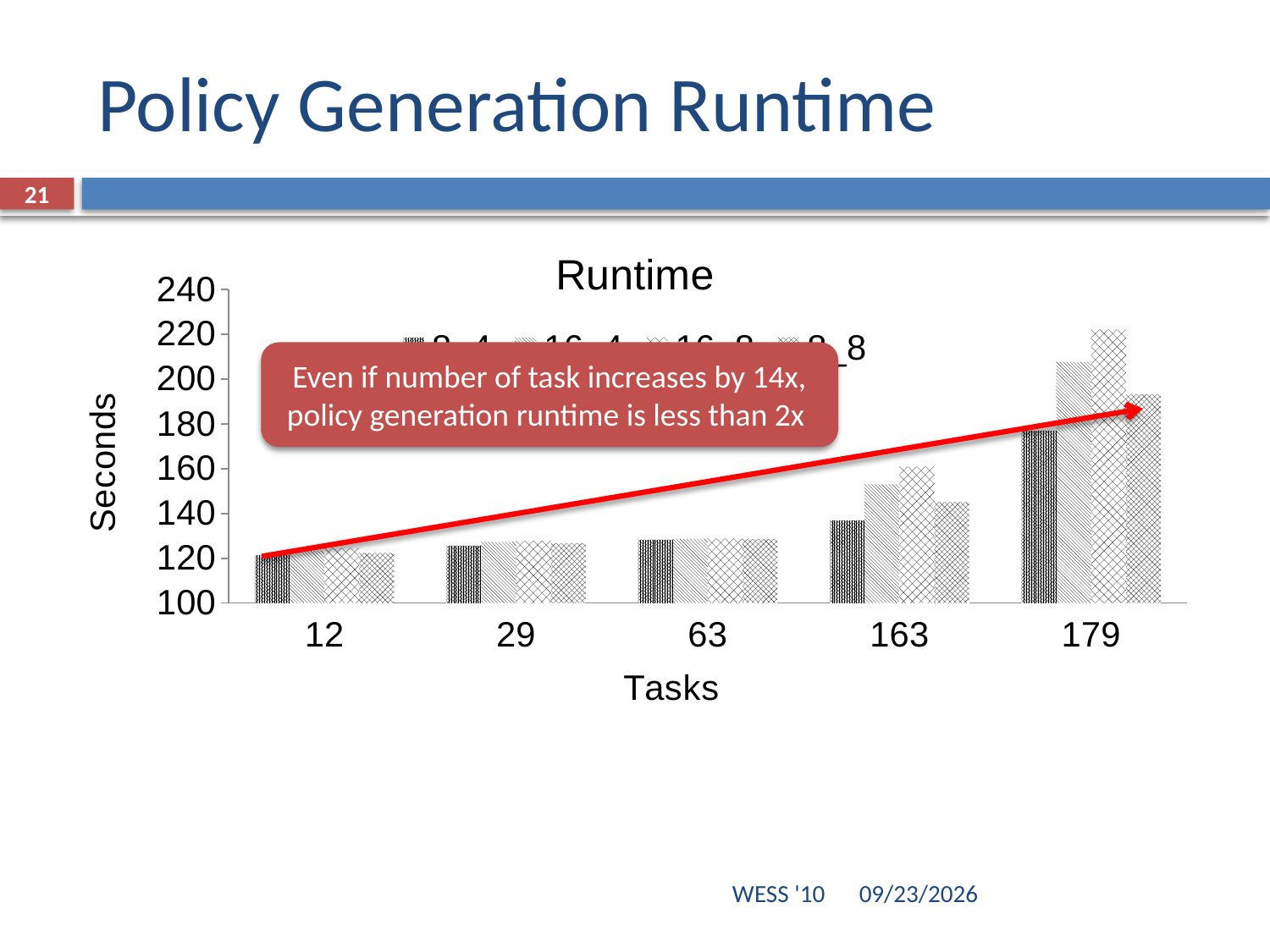
Which has taller bars in the chart, 163 tasks or 179 tasks? 179 Do the runtime values generally rise or fall as the number of tasks increases along the x axis? rise Are the bars for 12 tasks greater or less than 140? less What is the title of the chart? Runtime Are the bars for 63 tasks greater or less than 160? less What kind of chart is shown on the slide? bar chart How many bars are plotted for each task category in the chart? 4 How many task categories are shown on the x axis of the chart? 5 Which task category has the tallest bars in the chart? 179 Is the tallest bar for 163 tasks greater or less than 140? greater What is the label of the y axis of the chart? Seconds